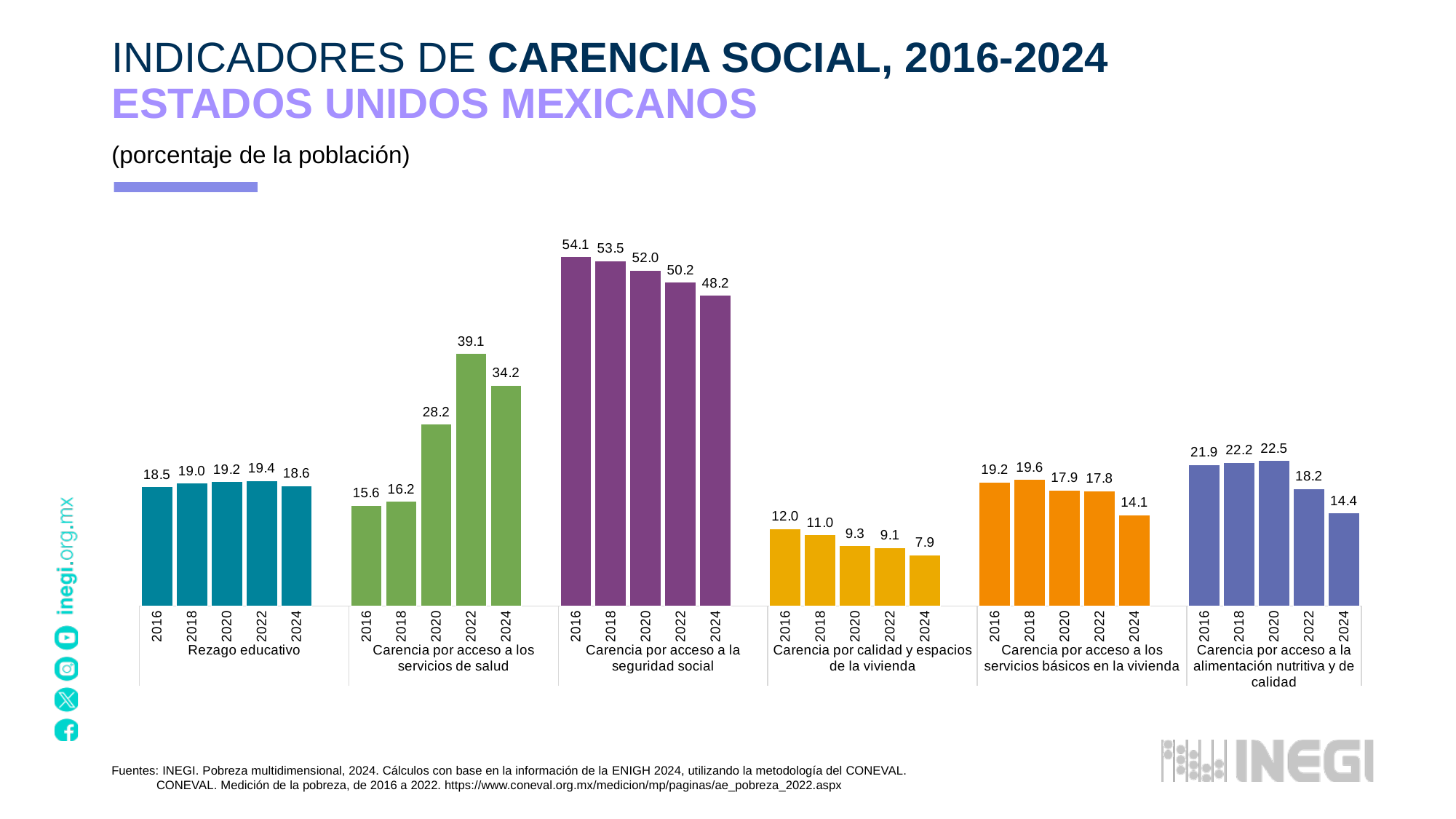
What is the difference between the 2016 and 2024 values for Carencia por acceso a la seguridad social? 5.9 What is the value for Carencia por calidad y espacios de la vivienda in 2024? 7.9 Which is larger: the 2024 value for Carencia por acceso a los servicios básicos en la vivienda or the 2024 value for Carencia por acceso a la alimentación nutritiva y de calidad? Carencia por acceso a la alimentación nutritiva y de calidad What is the value for Carencia por acceso a los servicios de salud in 2022? 39.1 What kind of chart is shown on the slide? Bar chart How many years are shown for each indicator? 5 What is the value for Carencia por acceso a la seguridad social in 2016? 54.1 Which indicator has the highest value in 2024? Carencia por acceso a la seguridad social Which indicator has the lowest value in 2024? Carencia por calidad y espacios de la vivienda Do the values for Carencia por calidad y espacios de la vivienda rise or fall from 2016 to 2024? Fall What is the value for Rezago educativo in 2024? 18.6 How many indicators (groups of bars) are shown on the chart? 6